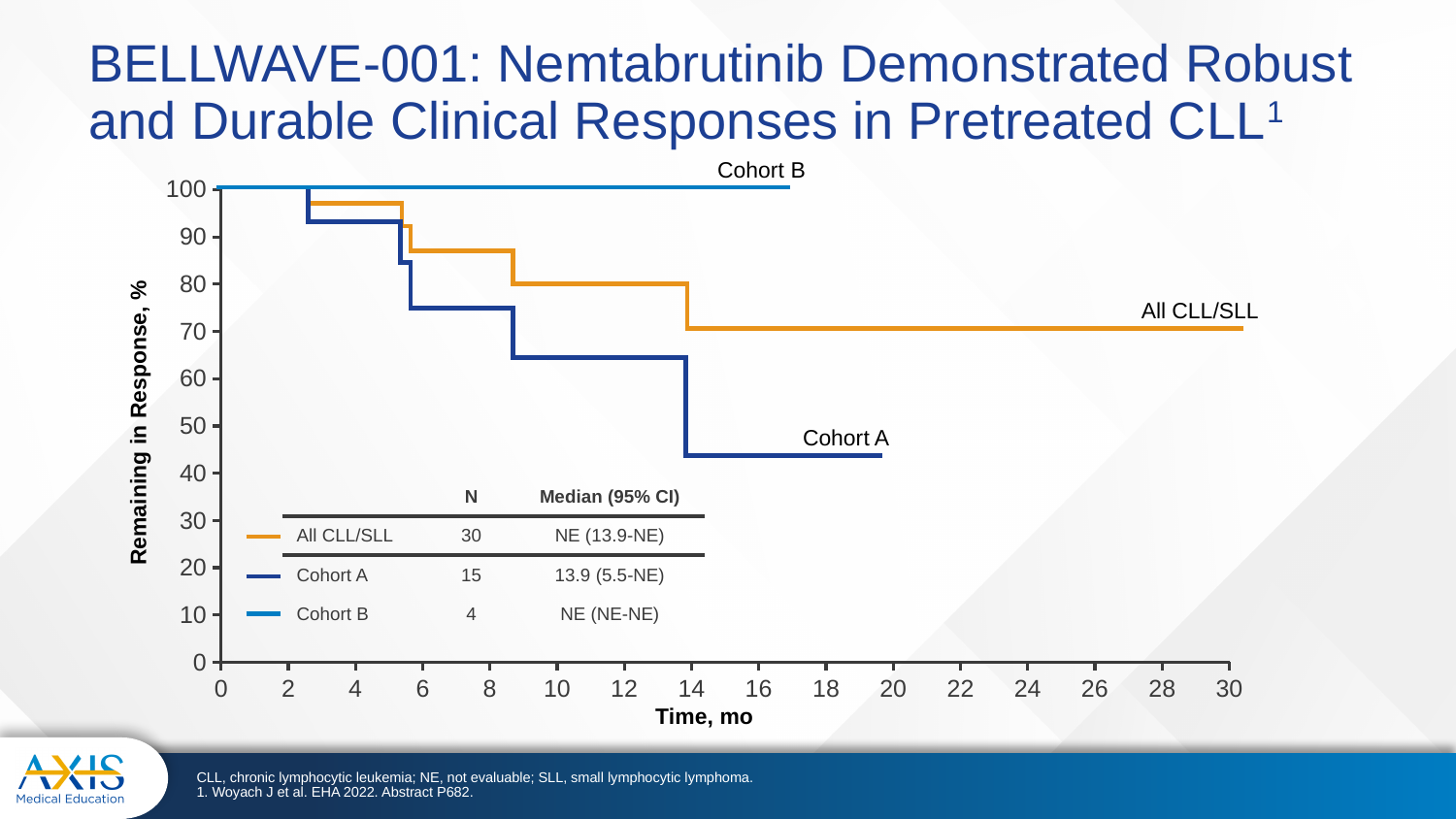
Is the value for All CLL/SLL at 20 months greater or less than 60? greater Is the value for Cohort A at 16 months greater or less than 50? less What is the N for All CLL/SLL in the legend table? 30 Is the value for Cohort B at 10 months greater or less than 90? greater What is the N for Cohort A in the legend table? 15 What kind of chart is shown on the slide? line chart How many series does the legend list? 3 Which series has the lowest value at 18 months? Cohort A At 16 months, which is higher: All CLL/SLL or Cohort A? All CLL/SLL What is the median (95% CI) for Cohort A? 13.9 (5.5-NE) Does the Cohort A curve rise or fall as time increases? fall What is the median (95% CI) for Cohort B? NE (NE-NE)